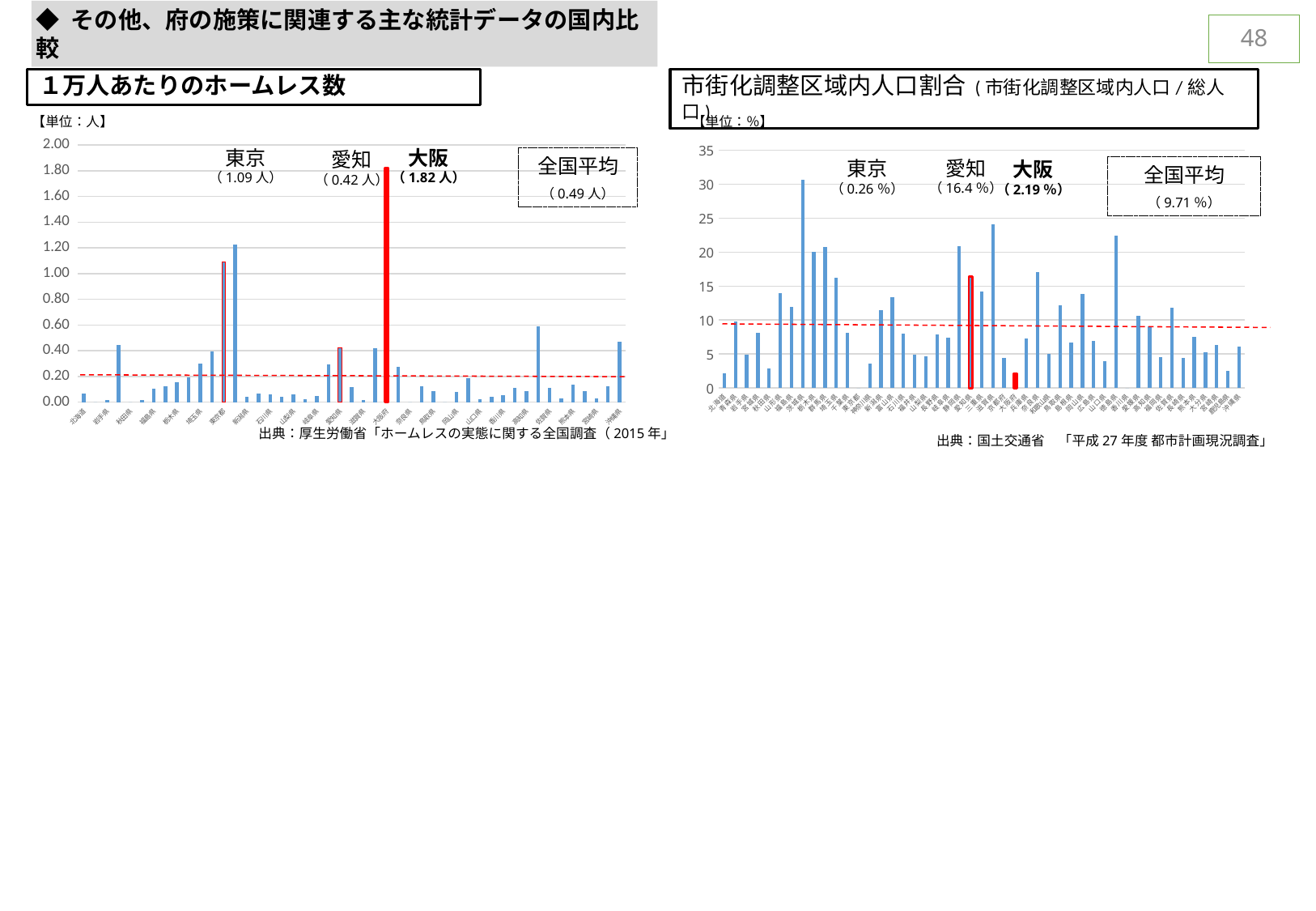
On the right chart (市街化調整区域内人口割合), what is the difference between the values for 愛知 and 大阪? 14.21 % On the left chart (１万人あたりのホームレス数), what is the value shown for 大阪? 1.82 人 On the left chart (１万人あたりのホームレス数), what is the 全国平均 value? 0.49 人 On the right chart (市街化調整区域内人口割合), which of the three labelled prefectures (東京, 愛知, 大阪) has the lowest value? 東京 On the left chart (１万人あたりのホームレス数), what is the difference between the values for 大阪 and 東京? 0.73 人 What type of chart is used for the left chart (１万人あたりのホームレス数)? bar chart On the left chart (１万人あたりのホームレス数), is the value for 愛知 larger or smaller than the 全国平均? smaller On the right chart (市街化調整区域内人口割合), what is the value shown for 愛知? 16.4 % On the right chart (市街化調整区域内人口割合), what is the value shown for 大阪? 2.19 % On the left chart (１万人あたりのホームレス数), what is the value shown for 東京? 1.09 人 On the left chart (１万人あたりのホームレス数), which of the three labelled prefectures (東京, 愛知, 大阪) has the highest value? 大阪 On the right chart (市街化調整区域内人口割合), what is the 全国平均 value? 9.71 %